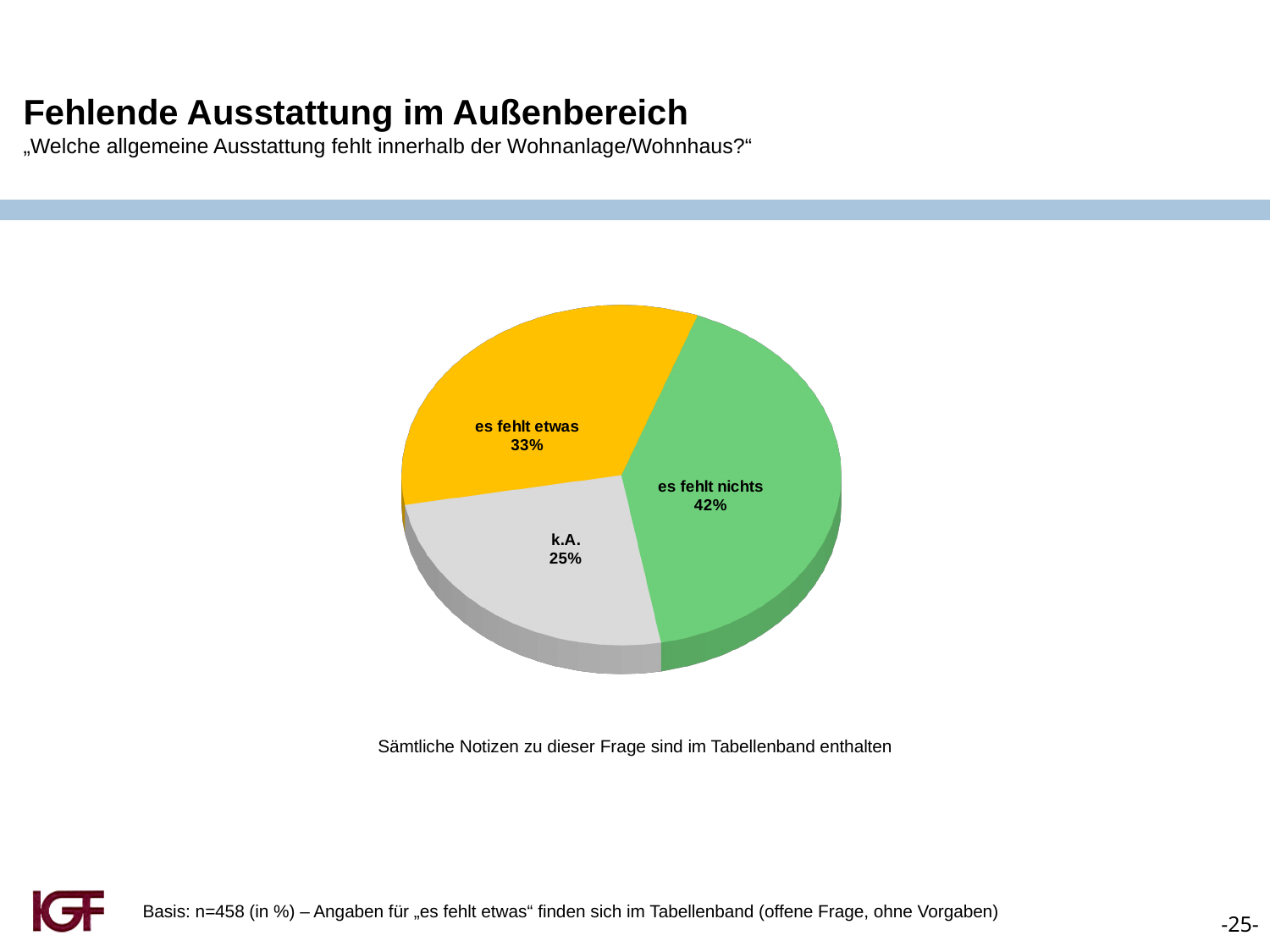
What colour is the "es fehlt nichts" slice? green How many slices does the pie chart have? 3 What percentage is shown for "k.A."? 25% Which is larger: the share for "es fehlt etwas" or the share for "k.A."? es fehlt etwas What is the difference in percentage points between "es fehlt nichts" and "es fehlt etwas"? 9 What type of chart is shown on the slide? pie chart What percentage is shown for "es fehlt nichts"? 42% Which slice of the pie chart is the smallest? k.A. What percentage is shown for "es fehlt etwas"? 33% Which slice of the pie chart is the largest? es fehlt nichts What is the difference in percentage points between "es fehlt etwas" and "k.A."? 8 What is the title of the slide containing the pie chart? Fehlende Ausstattung im Außenbereich